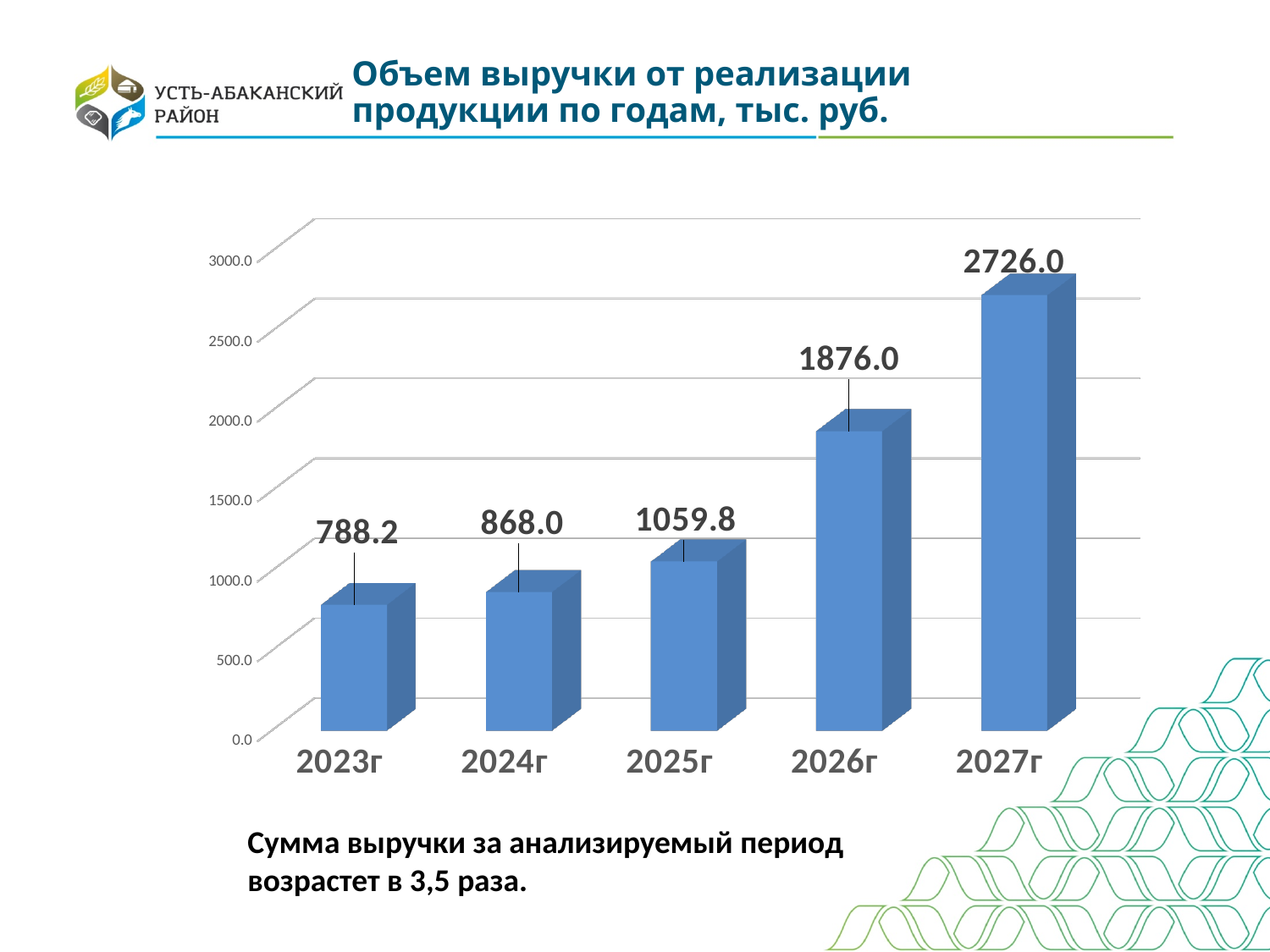
Which is larger, the value for 2024г or the value for 2026г? 2026г What is the revenue value shown for 2023г? 788.2 What is the revenue value shown for 2025г? 1059.8 What is the revenue value shown for 2027г? 2726.0 Do the values rise or fall from 2023г to 2027г? rise What kind of chart is shown on the slide? bar chart How many years are shown on the x axis of the chart? 5 Which year has the lowest revenue value? 2023г Is the value for 2026г greater or less than 1500.0? greater What is the difference between the values for 2025г and 2024г? 191.8 What is the difference between the values for 2027г and 2026г? 850.0 Which year has the highest revenue value? 2027г